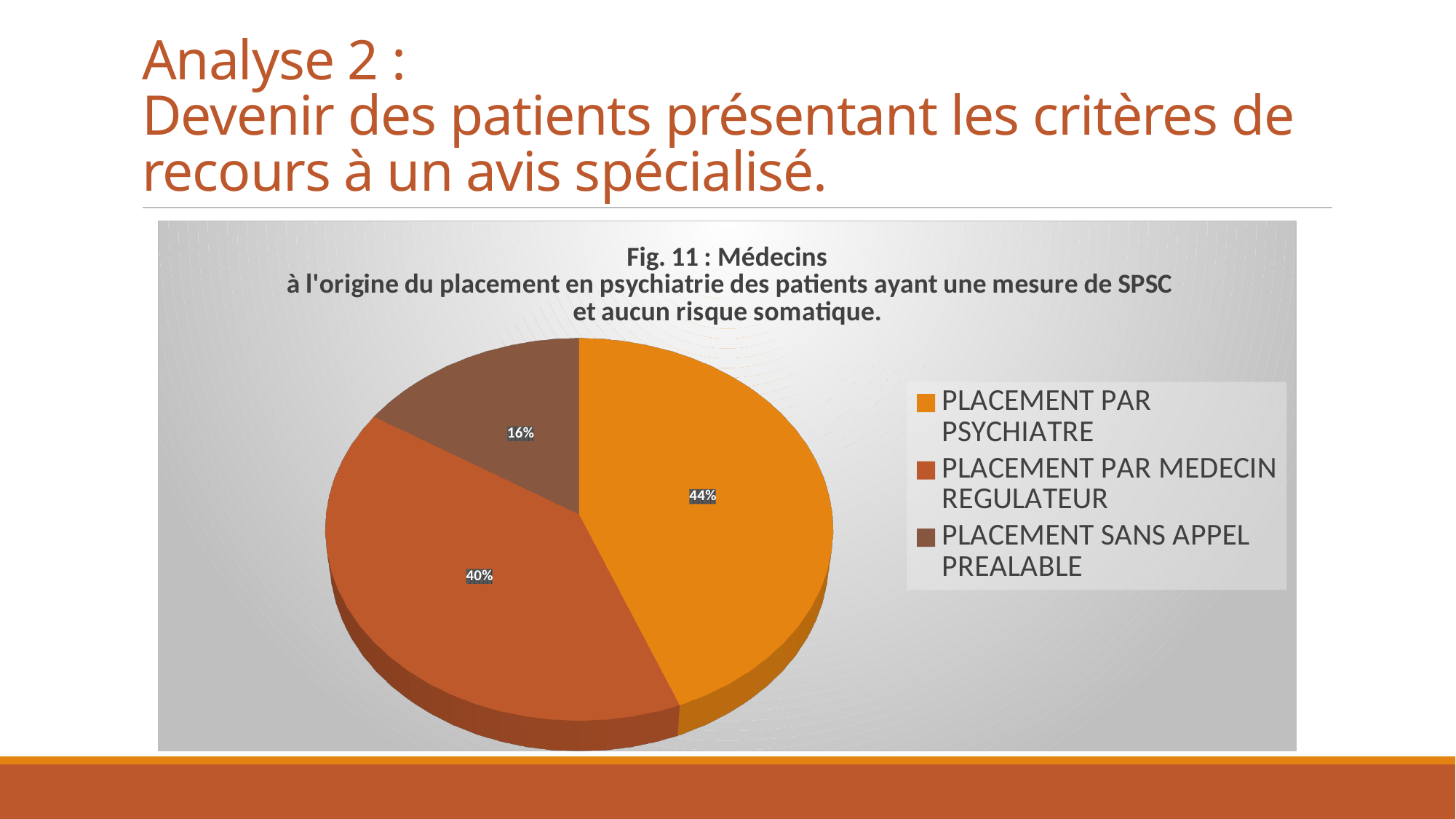
What percentage of the pie is PLACEMENT PAR MEDECIN REGULATEUR? 40% What percentage of the pie is PLACEMENT SANS APPEL PREALABLE? 16% What is the difference in percentage points between PLACEMENT PAR MEDECIN REGULATEUR and PLACEMENT SANS APPEL PREALABLE? 24 What kind of chart is shown on the slide? pie chart What percentage of the pie is PLACEMENT PAR PSYCHIATRE? 44% Which category has the smallest share of the pie? PLACEMENT SANS APPEL PREALABLE What is the difference in percentage points between PLACEMENT PAR PSYCHIATRE and PLACEMENT SANS APPEL PREALABLE? 28 What figure number is given in the chart title? Fig. 11 How many slices does the pie chart have? 3 Which is larger: the share for PLACEMENT PAR MEDECIN REGULATEUR or the share for PLACEMENT SANS APPEL PREALABLE? PLACEMENT PAR MEDECIN REGULATEUR Which category has the largest share of the pie? PLACEMENT PAR PSYCHIATRE How many entries does the legend list? 3